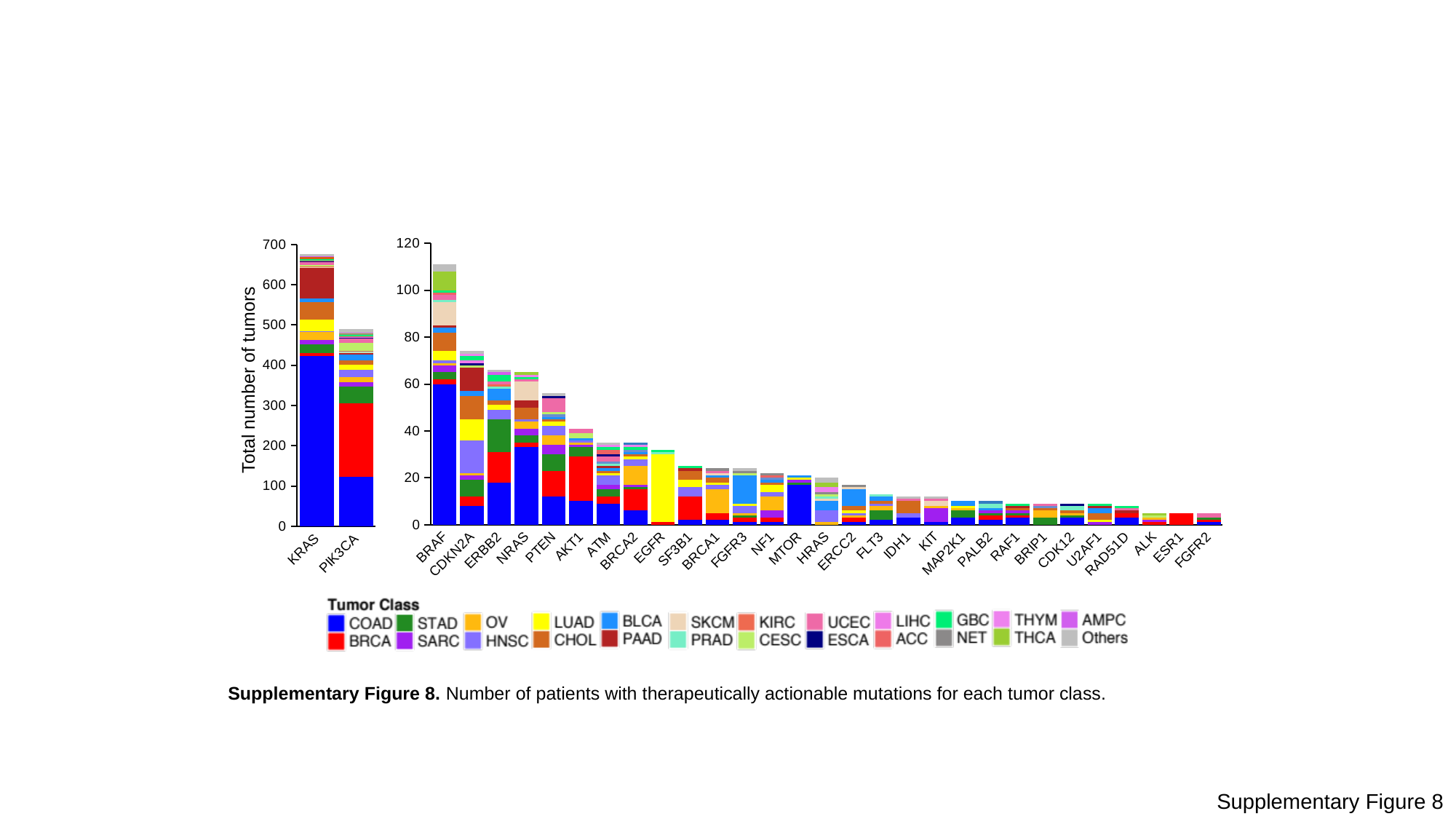
What is the label of the y axis? Total number of tumors How many genes are shown on the x axis of the right panel? 29 In the left panel, is the total for KRAS greater or less than 600? greater In the right panel, which gene has the highest total number of tumors? BRAF In the left panel, which gene has the taller bar, KRAS or PIK3CA? KRAS In the right panel, is the total for EGFR greater or less than 20? greater How many tumor classes does the legend list? 24 In the right panel, which bar is taller, BRAF or CDKN2A? BRAF In the right panel, is the total for BRAF greater or less than 100? greater What kind of chart is shown on the slide? Stacked bar chart In the right panel, do the bar totals generally rise or fall from left to right along the x axis? fall